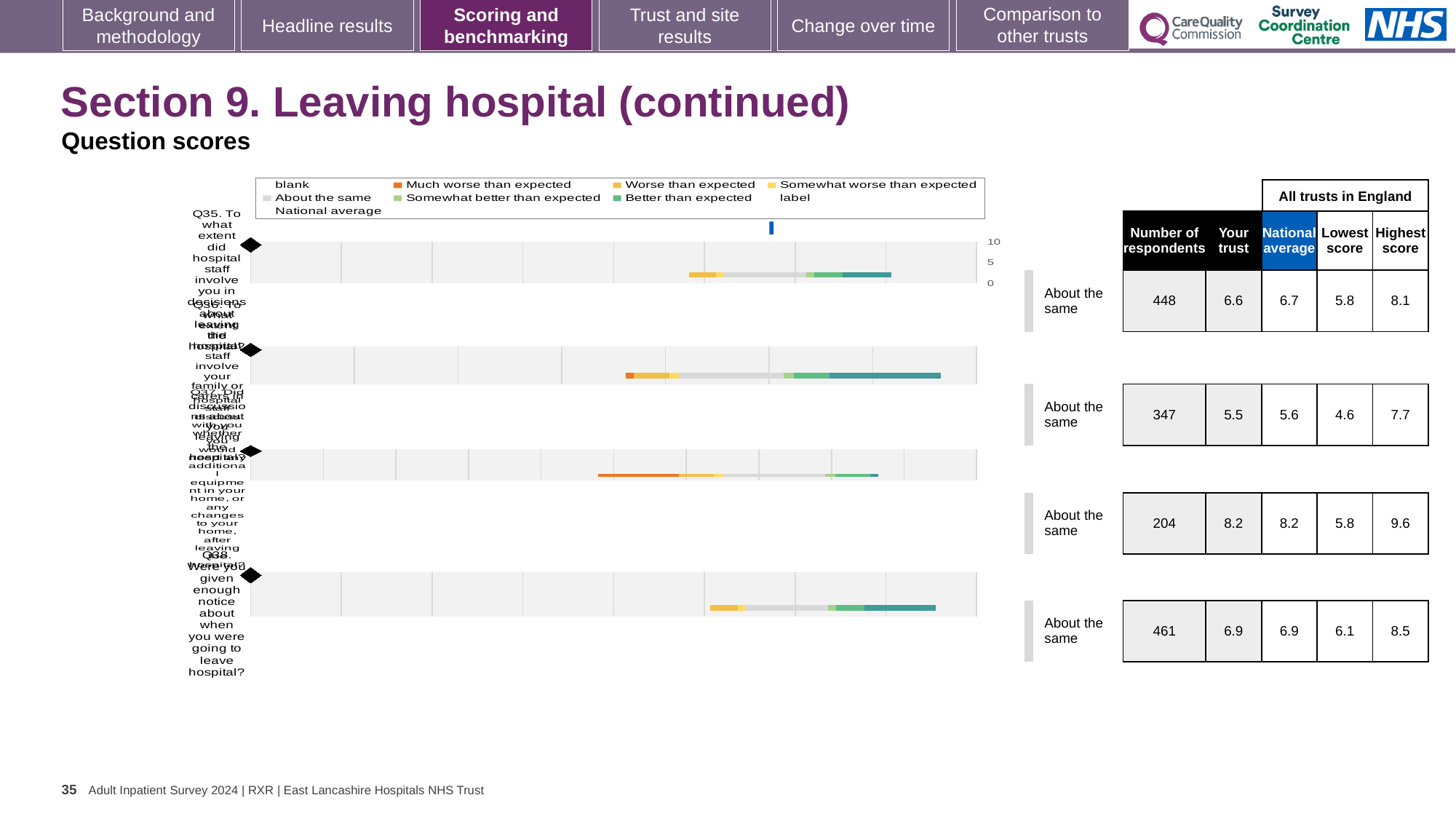
How many question charts are shown on the slide? 4 For the Q35 chart, which is higher: the 'Your trust' score or the national average? National average In the legend, what colour represents 'Better than expected'? teal What benchmark category is shown next to the Q38 chart? About the same In the legend, what colour represents 'Much worse than expected'? orange For the Q38 chart, what is the difference between the highest score and the lowest score across all trusts in England? 2.4 What kind of chart is used to show the question scores on this slide? bar chart For the Q38 chart (enough notice about leaving hospital), what is the national average score shown? 6.9 For the Q35 chart, how many respondents are shown? 448 For the Q35 chart (involving you in decisions about leaving hospital), what is the 'Your trust' score shown? 6.6 How many entries does the shared legend above the charts list? 9